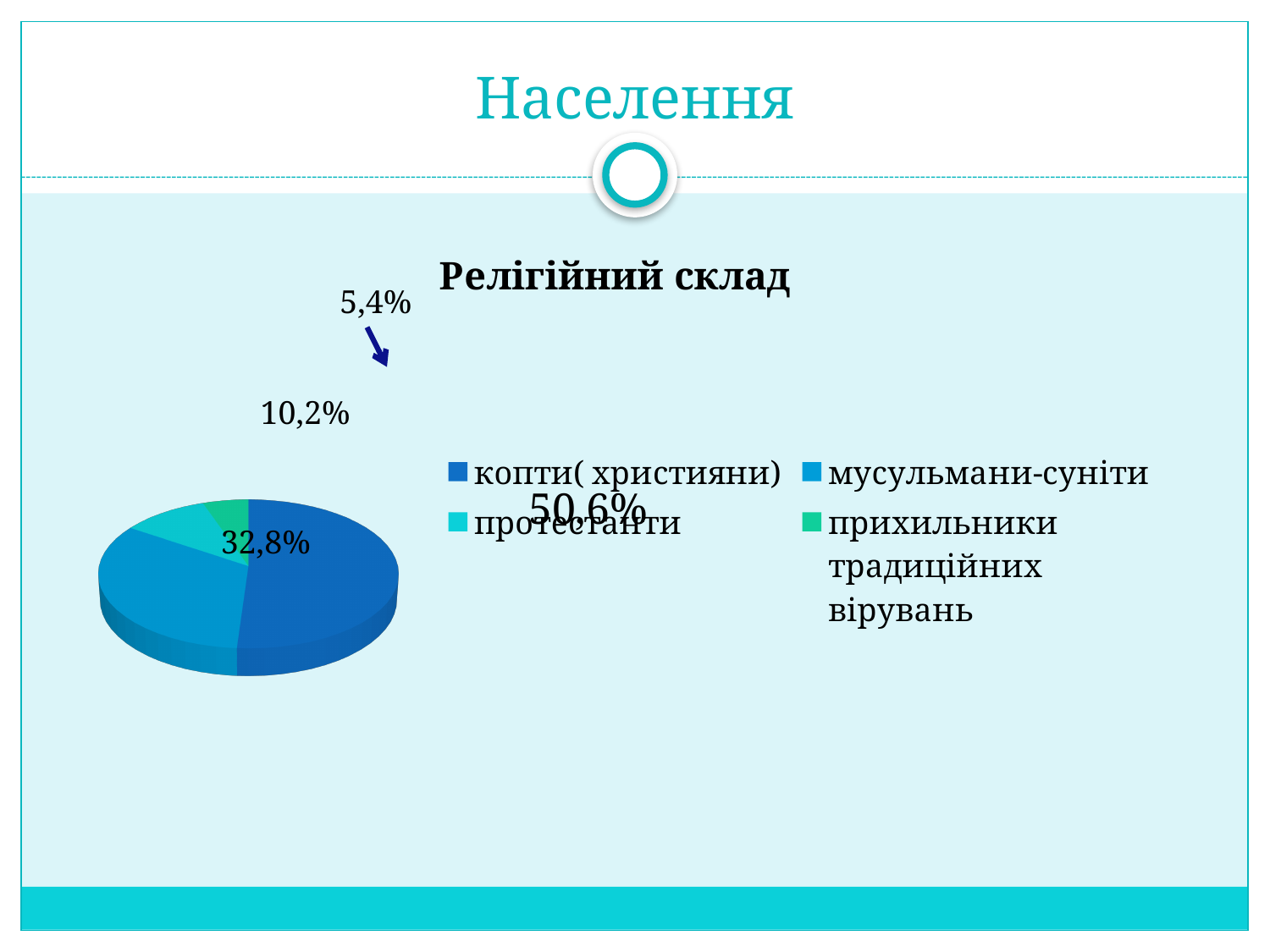
Which category has the smallest slice of the pie? прихильники традиційних вірувань What is the smallest percentage value labelled on the chart? 5,4% What kind of chart is shown on the slide? pie chart What share of the pie do прихильники традиційних вірувань hold? 5,4% What is the largest percentage value labelled on the chart? 50,6% Which category has the largest slice of the pie? копти( християни) Which is larger: the slice for мусульмани-суніти or the slice for протестанти? мусульмани-суніти What is the title of the chart? Релігійний склад How many entries does the legend list? 4 What share of the pie do копти( християни) hold? 50,6% How many categories does the pie chart have? 4 Which legend entry is shown in green? прихильники традиційних вірувань